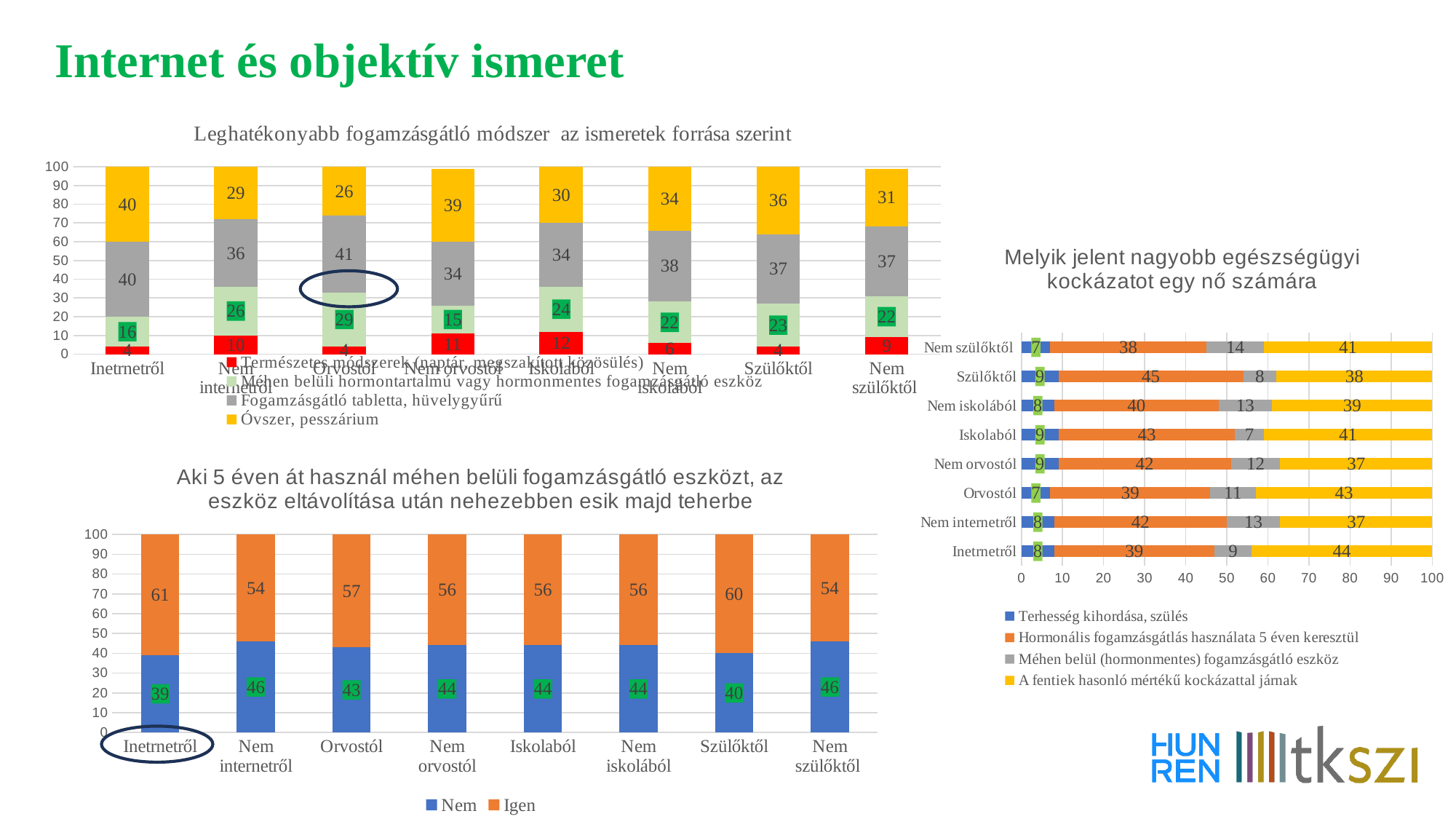
In the chart 'Aki 5 éven át használ méhen belüli fogamzásgátló eszközt...', what is the difference between the 'Igen' values for 'Inetrnetről' and 'Nem internetről'? 7 In the chart 'Melyik jelent nagyobb egészségügyi kockázatot egy nő számára', is the value of 'Méhen belül (hormonmentes) fogamzásgátló eszköz' larger for 'Nem szülőktől' or for 'Szülőktől'? Nem szülőktől In the chart 'Aki 5 éven át használ méhen belüli fogamzásgátló eszközt...', how many categories are shown on the x axis? 8 In the chart 'Leghatékonyabb fogamzásgátló módszer az ismeretek forrása szerint', how many series does the legend list? 4 In the chart 'Leghatékonyabb fogamzásgátló módszer az ismeretek forrása szerint', what is the value of 'Fogamzásgátló tabletta, hüvelygyűrű' for 'Orvostól'? 41 In the chart 'Melyik jelent nagyobb egészségügyi kockázatot egy nő számára', which category has the highest value for 'A fentiek hasonló mértékű kockázattal járnak'? Inetrnetről What kind of chart is 'Melyik jelent nagyobb egészségügyi kockázatot egy nő számára'? Stacked horizontal bar chart In the chart 'Melyik jelent nagyobb egészségügyi kockázatot egy nő számára', what is the value of 'Hormonális fogamzásgátlás használata 5 éven keresztül' for 'Szülőktől'? 45 In the chart 'Leghatékonyabb fogamzásgátló módszer az ismeretek forrása szerint', which category has the highest value for 'Természetes módszerek (naptár, megszakított közösülés)'? Iskolaból In the chart 'Leghatékonyabb fogamzásgátló módszer az ismeretek forrása szerint', what is the value of 'Óvszer, pesszárium' for 'Inetrnetről'? 40 In the chart 'Aki 5 éven át használ méhen belüli fogamzásgátló eszközt...', what is the 'Igen' value for 'Inetrnetről'? 61 In the chart 'Aki 5 éven át használ méhen belüli fogamzásgátló eszközt...', which category has the lowest 'Nem' value? Inetrnetről